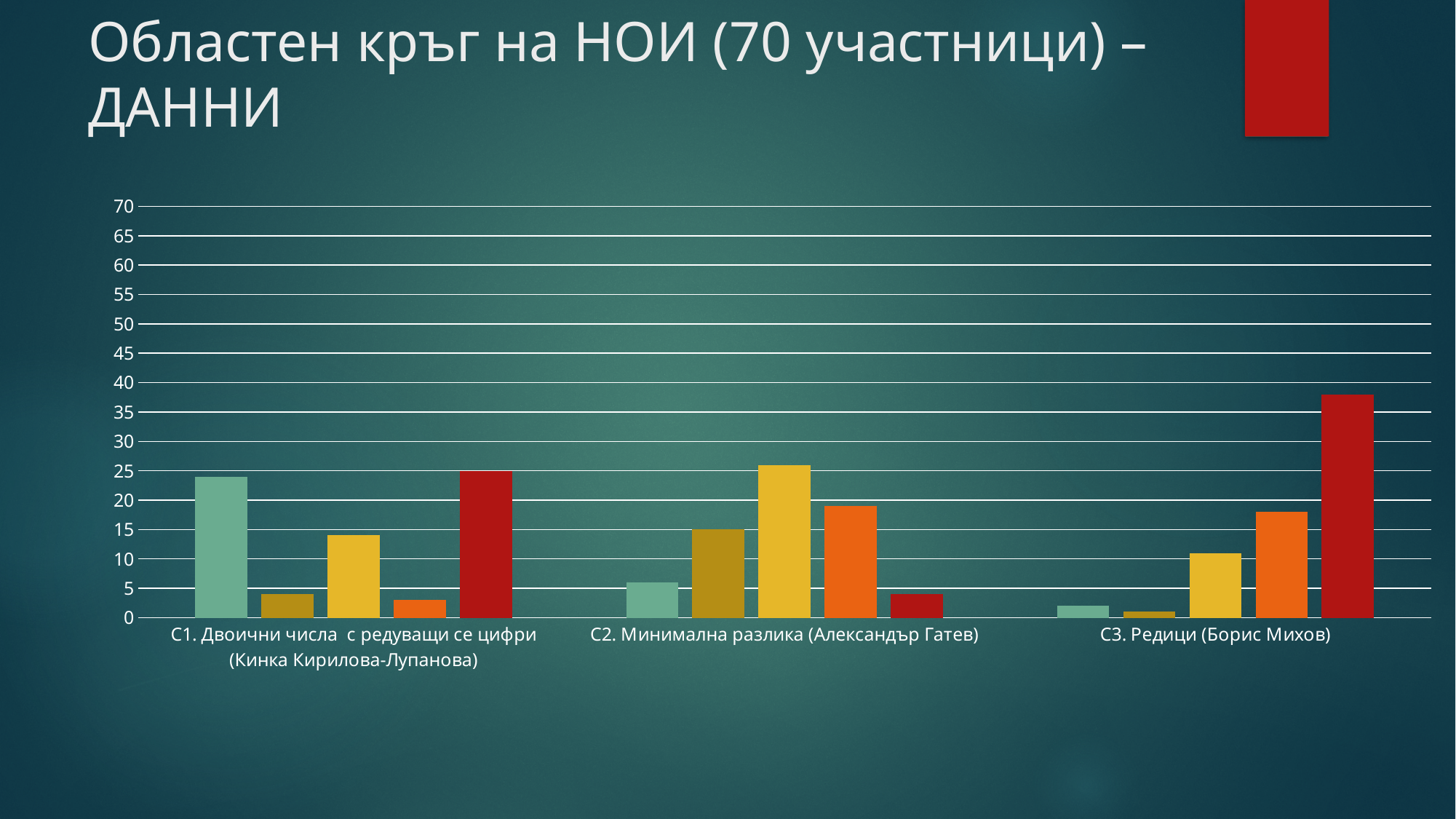
What kind of chart is shown on the slide? Bar chart Which category contains the tallest bar in the chart? С3. Редици (Борис Михов) Is the value of the teal (first) bar for С1. Двоични числа с редуващи се цифри greater or less than 20? greater Is the value of the orange bar for С1. Двоични числа с редуващи се цифри greater or less than 5? less For С3. Редици (Борис Михов), which is larger: the red bar or the orange bar? The red bar What is the title of the slide containing the chart? Областен кръг на НОИ (70 участници) – ДАННИ Is the value of the yellow bar for С2. Минимална разлика (Александър Гатев) greater or less than 20? greater For С2. Минимална разлика (Александър Гатев), which is larger: the yellow bar or the orange bar? The yellow bar How many categories are shown on the x axis of the chart? 3 Which category has the tallest red bar? С3. Редици (Борис Михов)